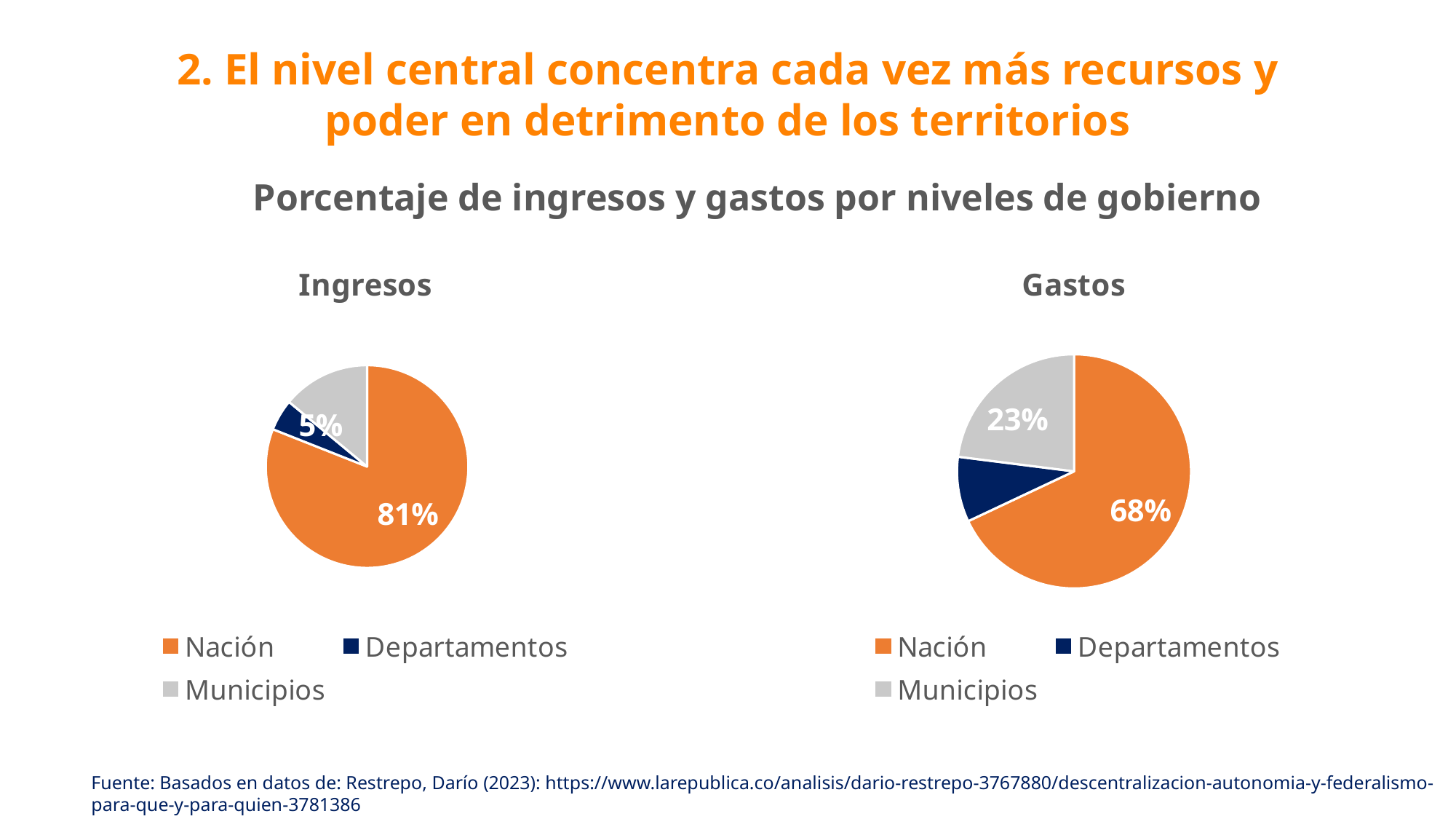
In the Gastos pie chart, what share does Municipios have? 23% What kind of chart is used for Ingresos and Gastos on this slide? Pie chart What is the overall title above the two pie charts? Porcentaje de ingresos y gastos por niveles de gobierno How many slices does the Gastos pie chart have? 3 In the Ingresos pie chart, which level of government has the largest slice? Nación By how many percentage points does Nación's share in Ingresos exceed its share in Gastos? 13 percentage points In the Ingresos pie chart, which level of government has the smallest slice? Departamentos In the Gastos pie chart, which level of government has the largest slice? Nación In the Ingresos pie chart, what share does Nación have? 81% Is the share of Nación larger in the Ingresos chart or in the Gastos chart? Ingresos In the Gastos pie chart, which level of government has the smallest slice? Departamentos In the Gastos pie chart, what share does Nación have? 68%